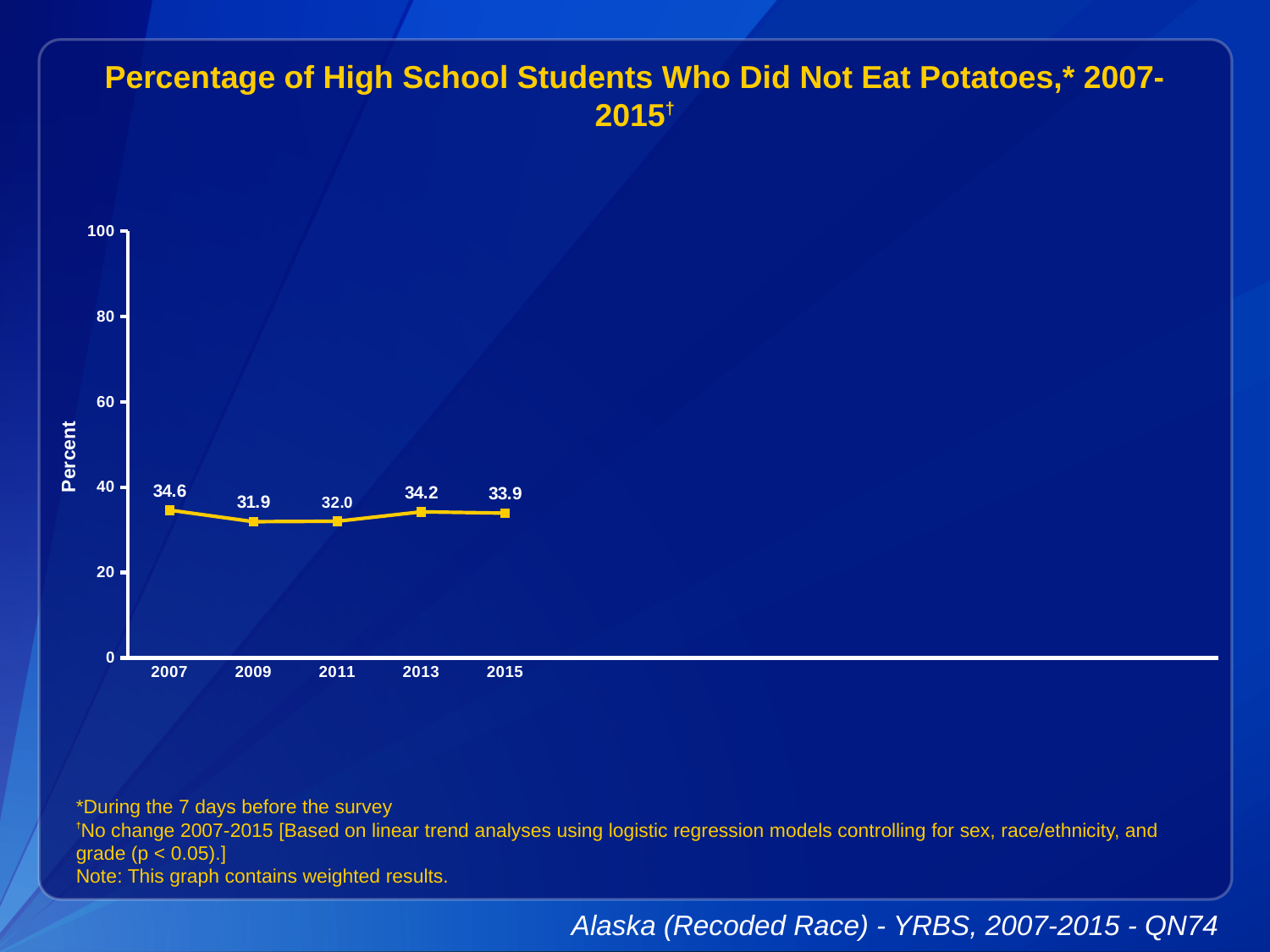
Which is larger, the value for 2013 or the value for 2015? 2013 What is the label on the y axis? Percent Is the value for 2011 greater or less than 40? less What is the difference between the values for 2007 and 2009? 2.7 What is the value for 2007? 34.6 What is the title of the chart? Percentage of High School Students Who Did Not Eat Potatoes,* 2007-2015† What kind of chart is shown? line chart What is the value for 2011? 32.0 Which year has the highest value? 2007 Which year has the lowest value? 2009 What is the value for 2015? 33.9 How many years are plotted on the chart? 5